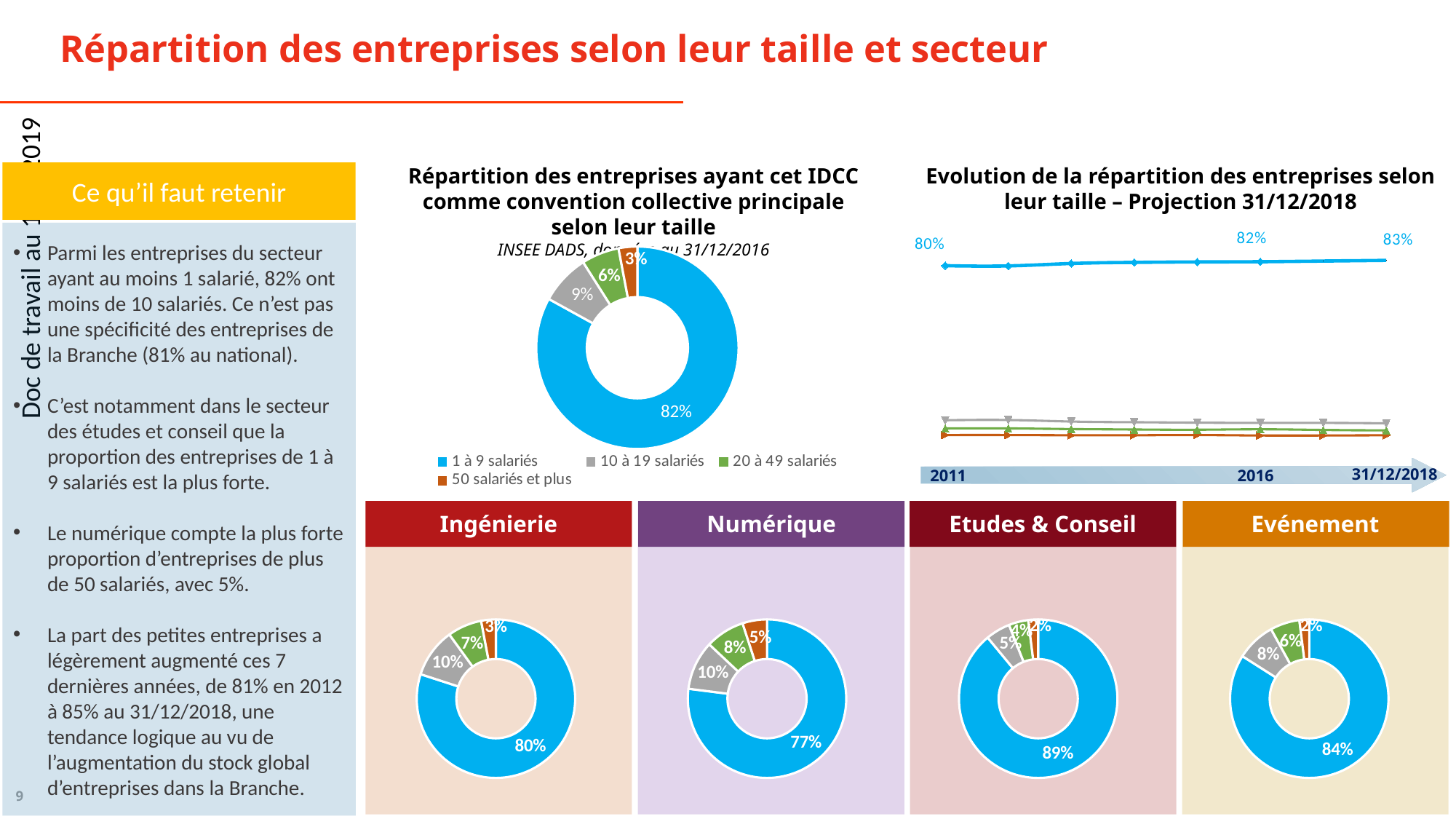
In the donut chart 'Répartition des entreprises ayant cet IDCC comme convention collective principale selon leur taille', which category has the smallest share? 50 salariés et plus What kind of chart is 'Evolution de la répartition des entreprises selon leur taille – Projection 31/12/2018'? line chart Which of the four sector donut charts at the bottom shows the highest share for the largest (blue) slice? Etudes & Conseil In the 'Ingénierie' donut chart, what share is shown for the largest slice? 80% In the 'Evénement' donut chart, what is the difference between the grey slice (8%) and the green slice (6%)? 2% In the donut chart 'Répartition des entreprises ayant cet IDCC comme convention collective principale selon leur taille', what share is shown for '10 à 19 salariés'? 9% In the chart 'Evolution de la répartition des entreprises selon leur taille – Projection 31/12/2018', does the top line rise or fall from 2011 to 31/12/2018? rise In the donut chart 'Répartition des entreprises ayant cet IDCC comme convention collective principale selon leur taille', what share is shown for '1 à 9 salariés'? 82% In the donut chart 'Répartition des entreprises ayant cet IDCC comme convention collective principale selon leur taille', what is the difference between the shares for '10 à 19 salariés' and '20 à 49 salariés'? 3% In the chart 'Evolution de la répartition des entreprises selon leur taille – Projection 31/12/2018', what value is labelled at the end of the top line for 31/12/2018? 83% In the 'Numérique' donut chart, what share is shown for the orange slice (50 salariés et plus)? 5% How many entries does the legend of the donut chart 'Répartition des entreprises ayant cet IDCC comme convention collective principale selon leur taille' list? 4